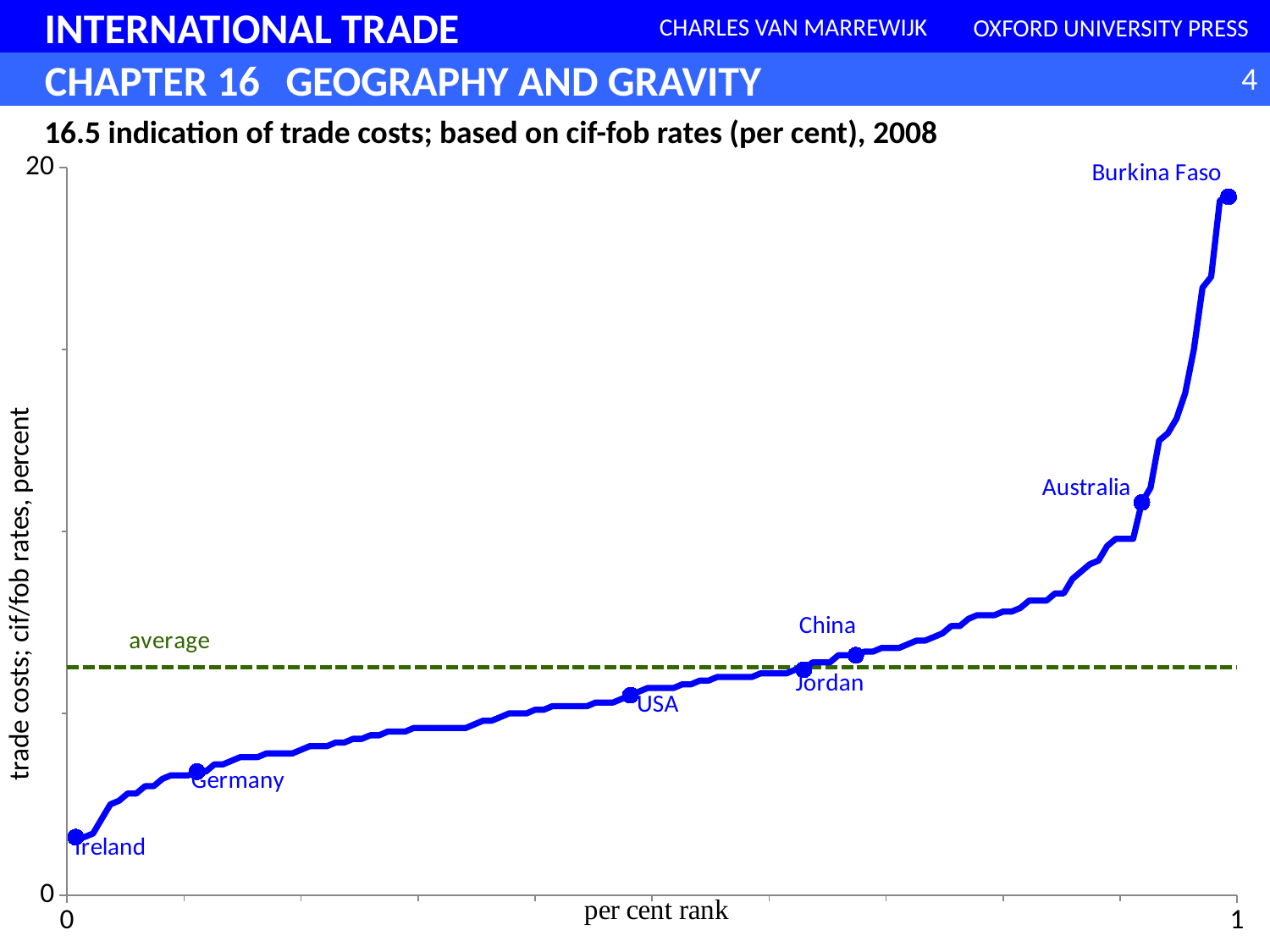
What is the title of the chart? 16.5 indication of trade costs; based on cif-fob rates (per cent), 2008 Which labelled country has the lowest trade costs on the chart? Ireland What kind of chart is shown on the slide? line chart Which has higher trade costs, Australia or China? Australia Do the plotted trade costs rise or fall as the per cent rank increases along the x axis? rise Is the value for Burkina Faso greater or less than 20? less Which has higher trade costs, Germany or USA? USA Which labelled country lies closest to the dashed average line? Jordan Which labelled country has the highest trade costs on the chart? Burkina Faso What is the label of the vertical axis? trade costs; cif/fob rates, percent Which has higher trade costs, Jordan or Ireland? Jordan How many countries are labelled on the chart? 7